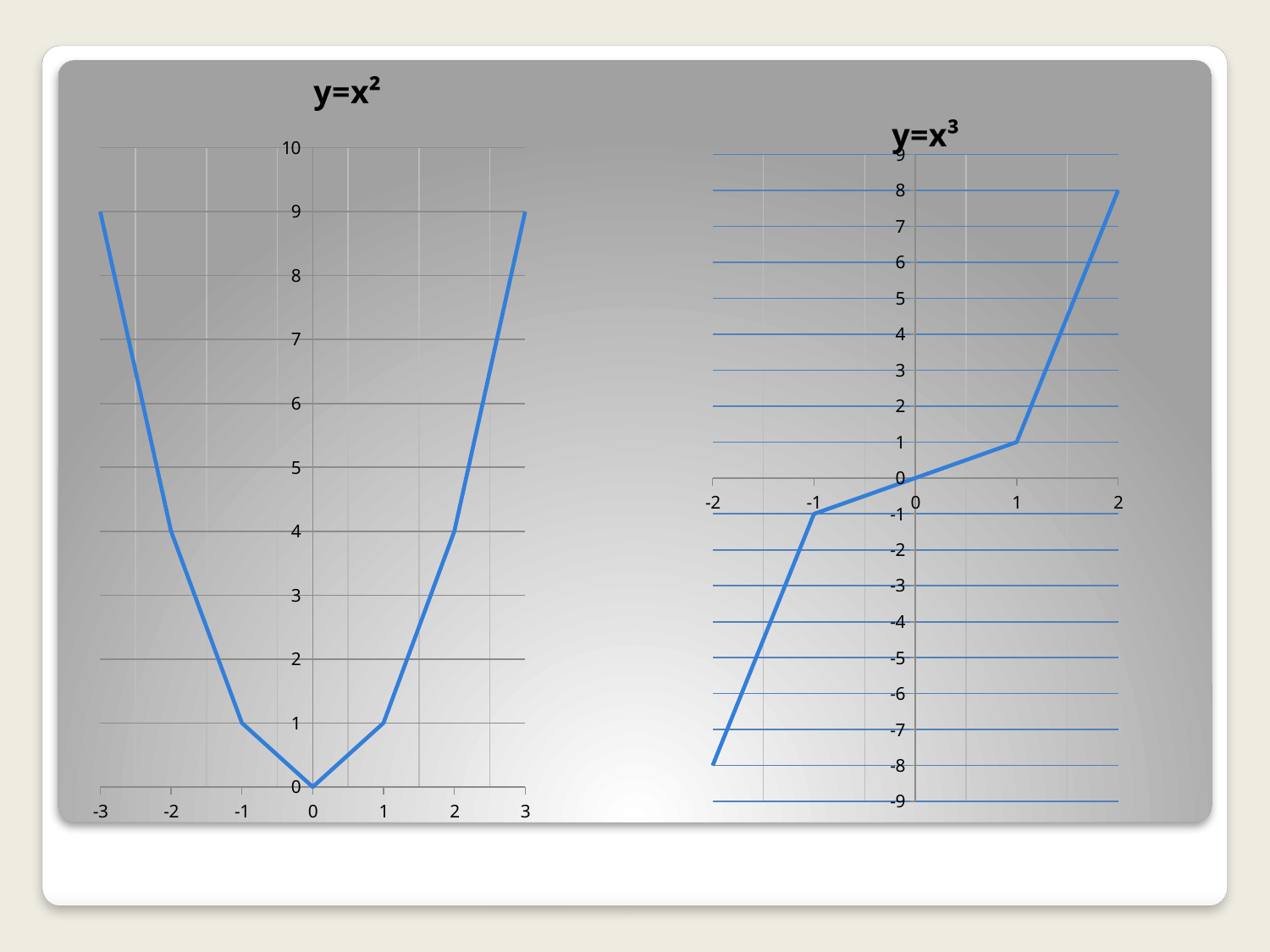
What type of chart is the y=x² chart on the left? line chart In the y=x³ chart, which has the larger y value, x = 1 or x = -1? x = 1 In the y=x³ chart, what is the y value at x = -2? -8 In the y=x² chart, at which x value is y lowest? 0 In the y=x³ chart, do the y values rise or fall as x increases from -2 to 2? rise In the y=x² chart, what is the y value at x = 3? 9 In the y=x³ chart, what is the y value at x = 2? 8 In the y=x² chart, what is the difference between the y values at x = 2 and x = 1? 3 In the y=x² chart, how many x values are labelled on the horizontal axis? 7 In the y=x³ chart, is the y value at x = 2 greater or less than 5? greater What is the title of the chart on the right? y=x³ In the y=x² chart, what is the y value at x = -2? 4